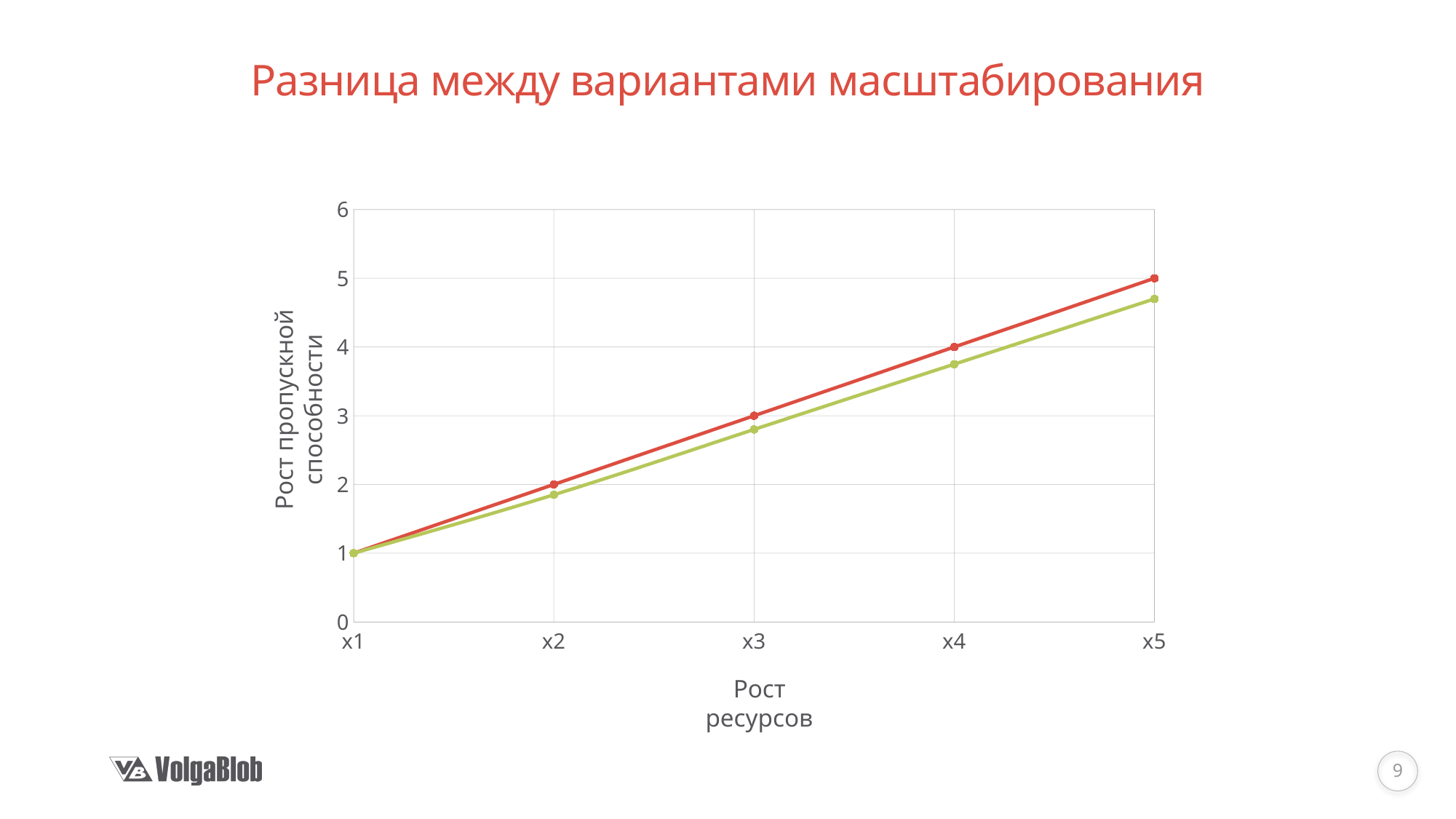
What is the value of the red line at x1? 1 Is the value of the green line at x4 greater or less than 3? greater What is the value of the red line at x3? 3 What is the value of the red line at x5? 5 What kind of chart is shown on the slide? line chart Is the value of the green line at x5 greater or less than 5? less At x4, which line has the higher value, the red or the green? red What is the title of the chart on the slide? Разница между вариантами масштабирования How many lines are plotted on the chart? 2 Do the values of the red line rise or fall from x1 to x5? rise What is the difference between the red line's values at x5 and x2? 3 How many points are on the x axis of the chart? 5